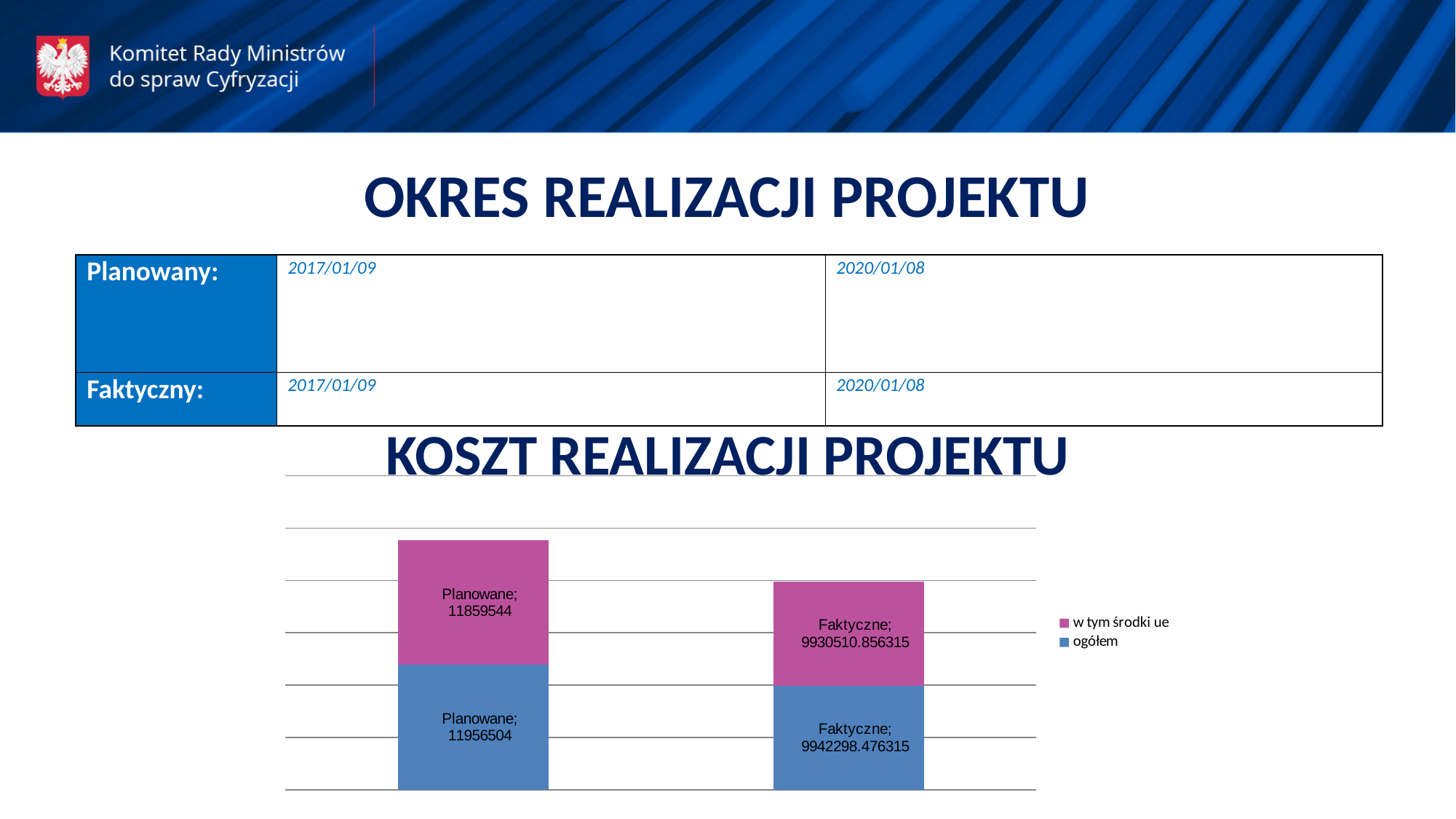
What is the value of the w tym środki ue series for Planowane? 11859544 What is the difference between the ogółem value and the w tym środki ue value for Planowane? 96960 How many series does the chart legend list? 2 What is the total of the stacked bar for Planowane? 23816048 How many categories are shown on the chart? 2 What is the value of the ogółem series for Planowane? 11956504 What type of chart is shown under the title KOSZT REALIZACJI PROJEKTU? Stacked bar chart What is the difference between the ogółem values for Planowane and Faktyczne? 2014205.523685 Which category has the higher ogółem value, Planowane or Faktyczne? Planowane What is the value of the ogółem series for Faktyczne? 9942298.476315 What is the value of the w tym środki ue series for Faktyczne? 9930510.856315 Which colour represents the w tym środki ue series in the chart? Pink (magenta)